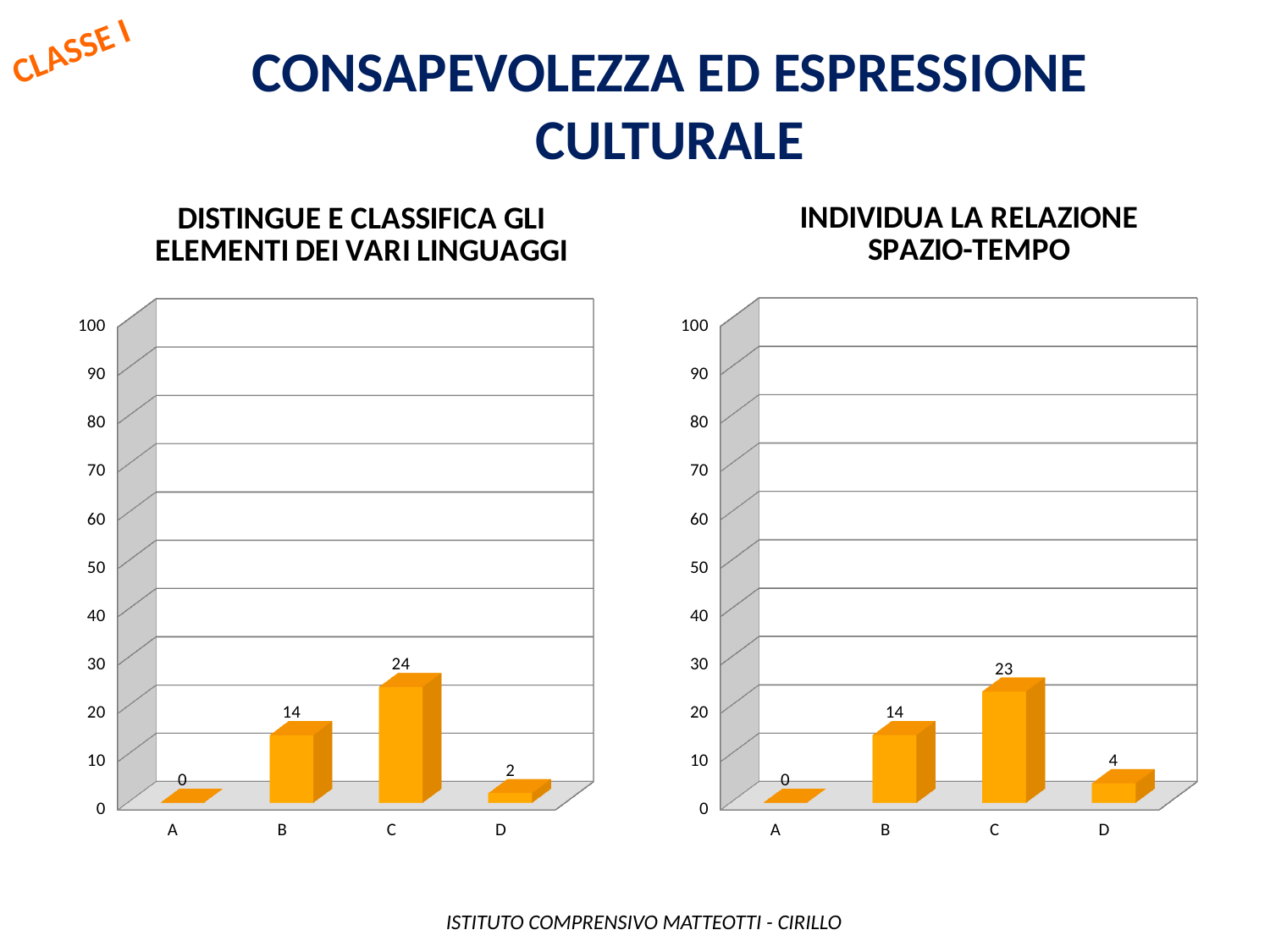
In the left chart, is the value for C greater or less than 20? greater In the left chart, what is the value for category A? 0 In the chart titled 'INDIVIDUA LA RELAZIONE SPAZIO-TEMPO', what is the value for category D? 4 What is the title of the chart on the right of the slide? INDIVIDUA LA RELAZIONE SPAZIO-TEMPO In the chart titled 'INDIVIDUA LA RELAZIONE SPAZIO-TEMPO', what is the difference between the values for C and D? 19 In the chart titled 'DISTINGUE E CLASSIFICA GLI ELEMENTI DEI VARI LINGUAGGI', what is the value for category C? 24 In the right chart, which is larger, the value for B or the value for D? B In the chart titled 'DISTINGUE E CLASSIFICA GLI ELEMENTI DEI VARI LINGUAGGI', what is the difference between the values for C and B? 10 How many categories are shown on the x axis of the left chart? 4 In the right chart, which category has the lowest value? A In the left chart, which category has the highest value? C What kind of chart is the chart titled 'INDIVIDUA LA RELAZIONE SPAZIO-TEMPO'? bar chart